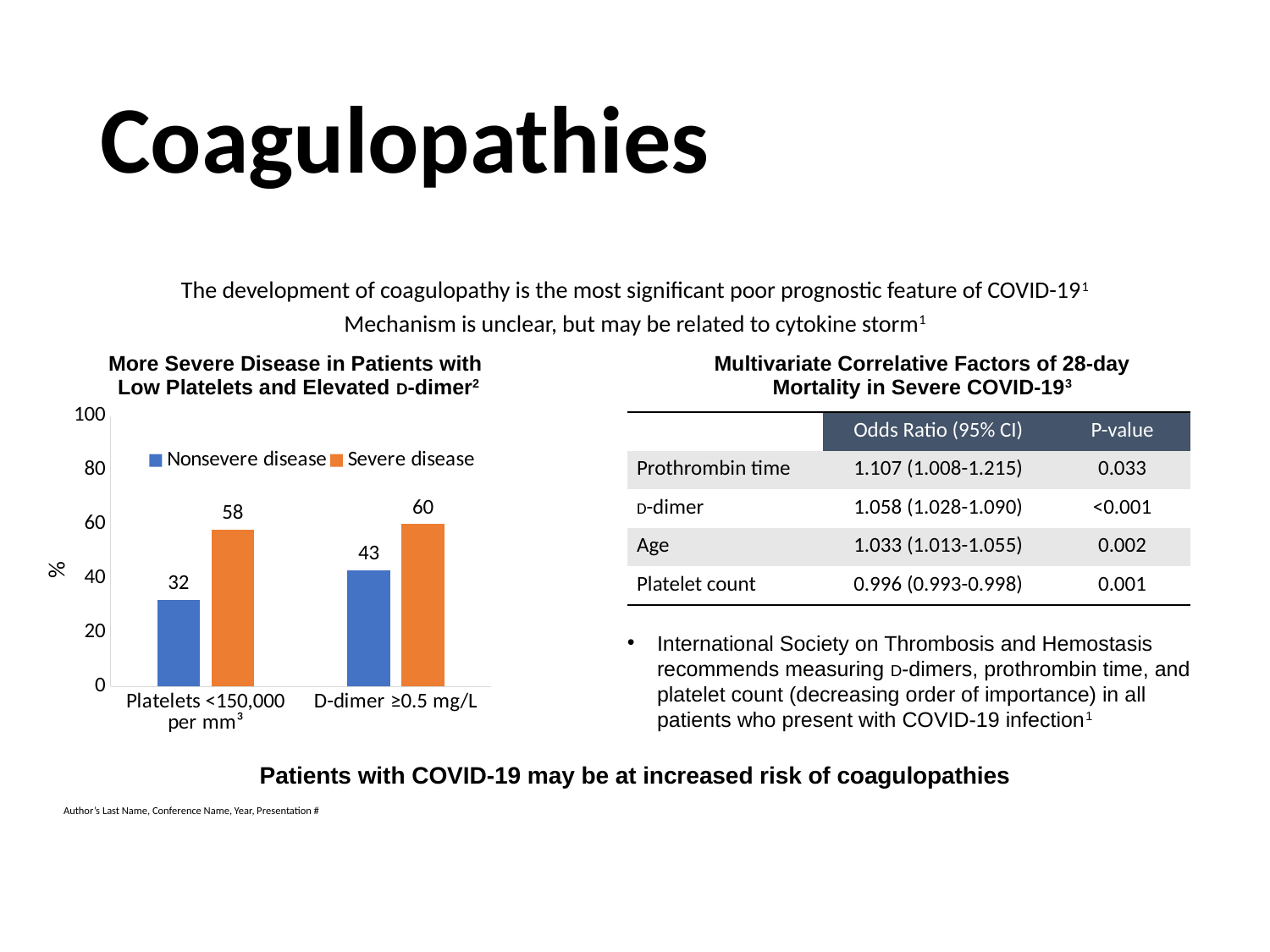
What is the value for Nonsevere disease in the D-dimer ≥0.5 mg/L category? 43 What kind of chart is shown on the slide? Bar chart Which bar has the highest value in the chart? Severe disease, D-dimer ≥0.5 mg/L How many series does the chart legend list? 2 What is the value for Severe disease in the D-dimer ≥0.5 mg/L category? 60 How many categories are shown on the x axis of the chart? 2 What is the value for Nonsevere disease in the Platelets <150,000 per mm³ category? 32 What is the title of the chart? More Severe Disease in Patients with Low Platelets and Elevated D-dimer What is the difference between Severe disease and Nonsevere disease in the Platelets <150,000 per mm³ category? 26 Which bar has the lowest value in the chart? Nonsevere disease, Platelets <150,000 per mm³ Which is larger in the D-dimer ≥0.5 mg/L category: Nonsevere disease or Severe disease? Severe disease What is the value for Severe disease in the Platelets <150,000 per mm³ category? 58